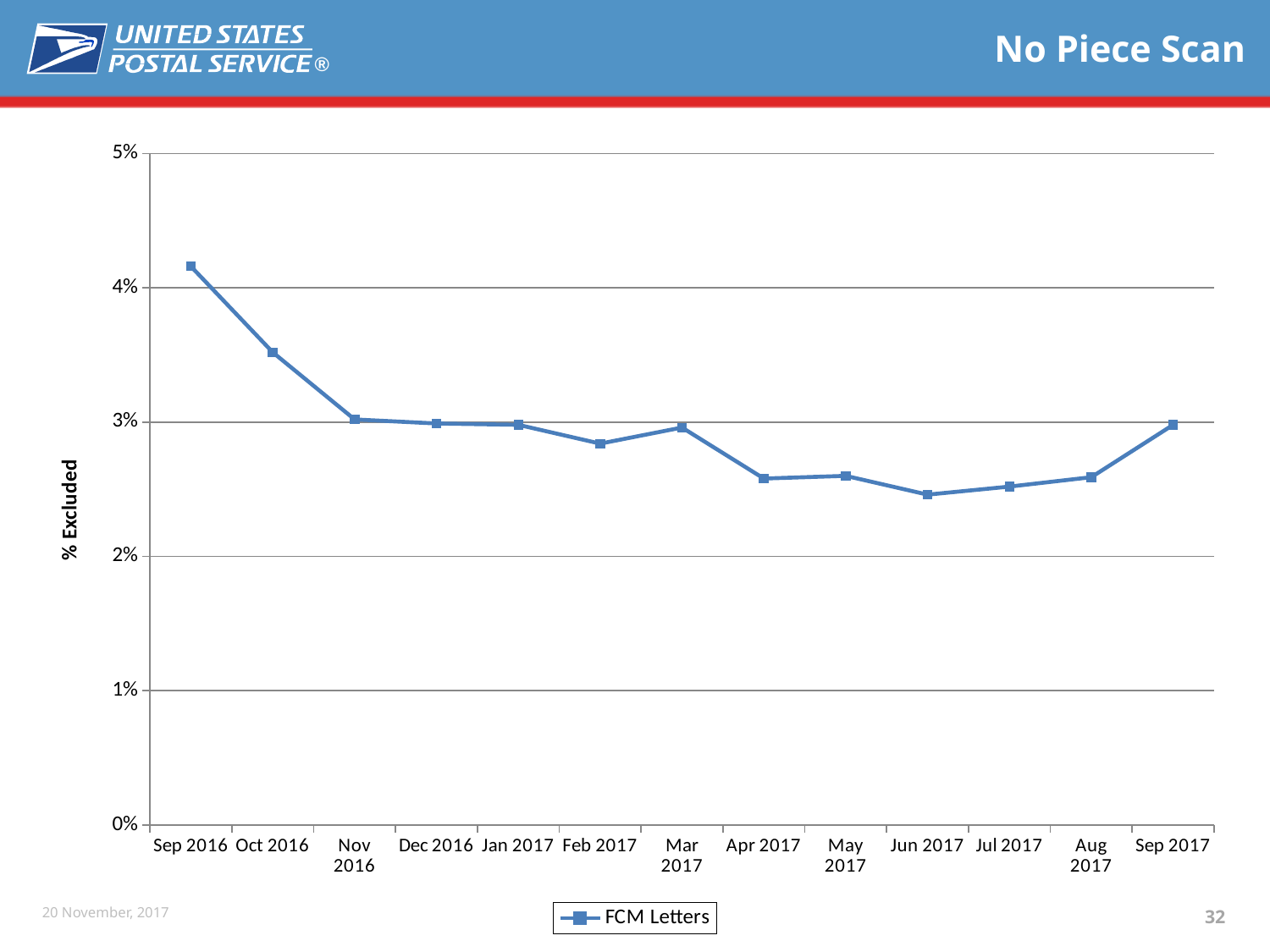
Is the value for Sep 2016 greater or less than 4%? greater Which is larger, the value for Oct 2016 or the value for Apr 2017? Oct 2016 What kind of chart is shown on the slide? line chart How many data points are plotted on the FCM Letters line? 13 What is the label on the vertical axis of the chart? % Excluded Which month has the lowest % Excluded value? Jun 2017 Does the % Excluded value rise or fall from Sep 2016 to Jun 2017? fall Is the value for Jun 2017 greater or less than 2%? greater Which month has the highest % Excluded value? Sep 2016 Is the value for Apr 2017 greater or less than 3%? less How many series does the legend list? 1